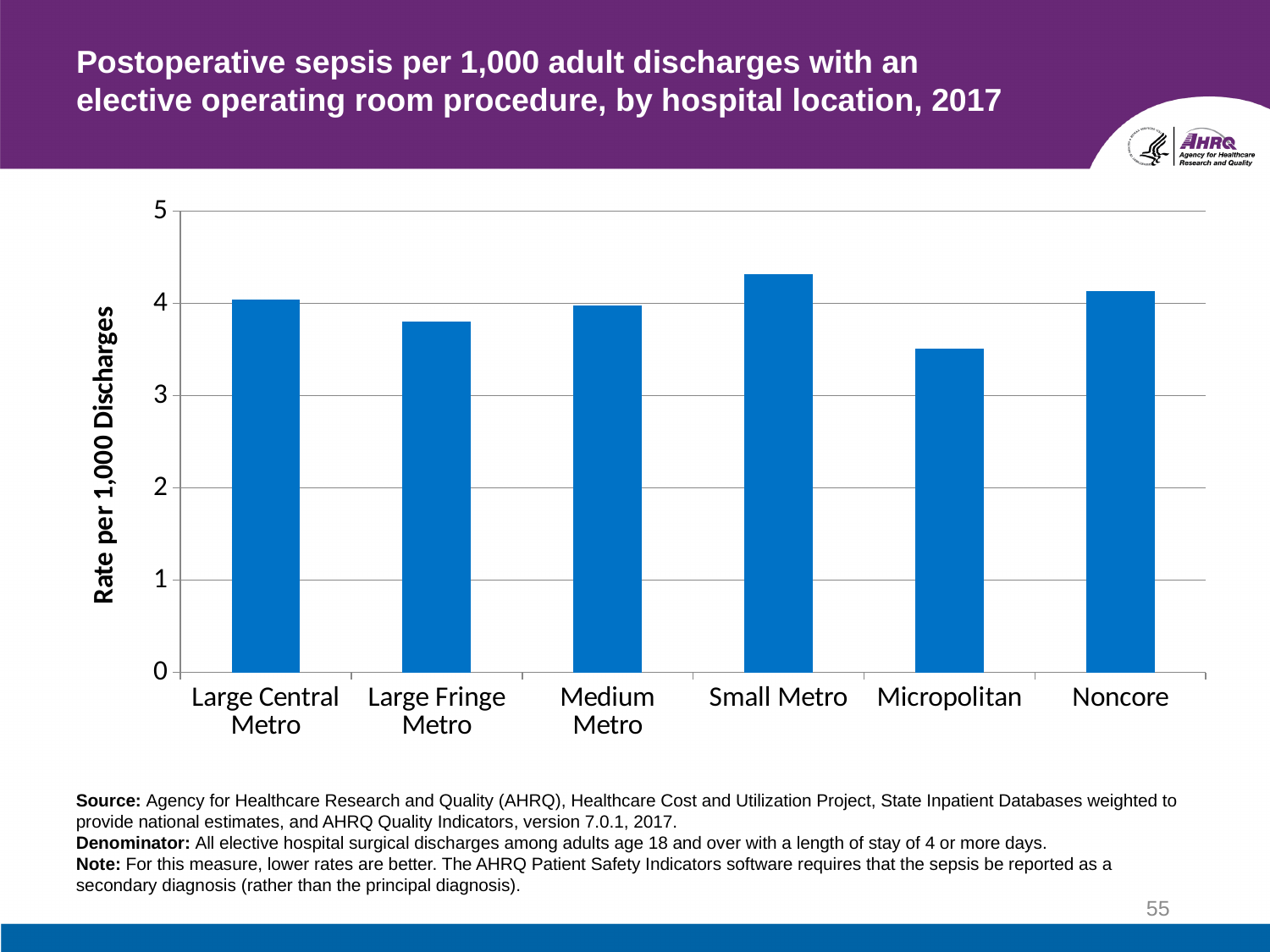
Is the value for Small Metro greater or less than 4? greater Which has a higher rate, Large Fringe Metro or Noncore? Noncore Is the value for Large Fringe Metro greater or less than 4? less What is the label on the vertical axis of the chart? Rate per 1,000 Discharges Is the value for Micropolitan greater or less than 4? less What year of data does the chart title say is shown? 2017 Which has a higher rate, Small Metro or Micropolitan? Small Metro How many hospital location categories are shown on the x axis? 6 Which hospital location has the lowest postoperative sepsis rate? Micropolitan What kind of chart is shown on the slide? Bar chart Which hospital location has the highest postoperative sepsis rate? Small Metro